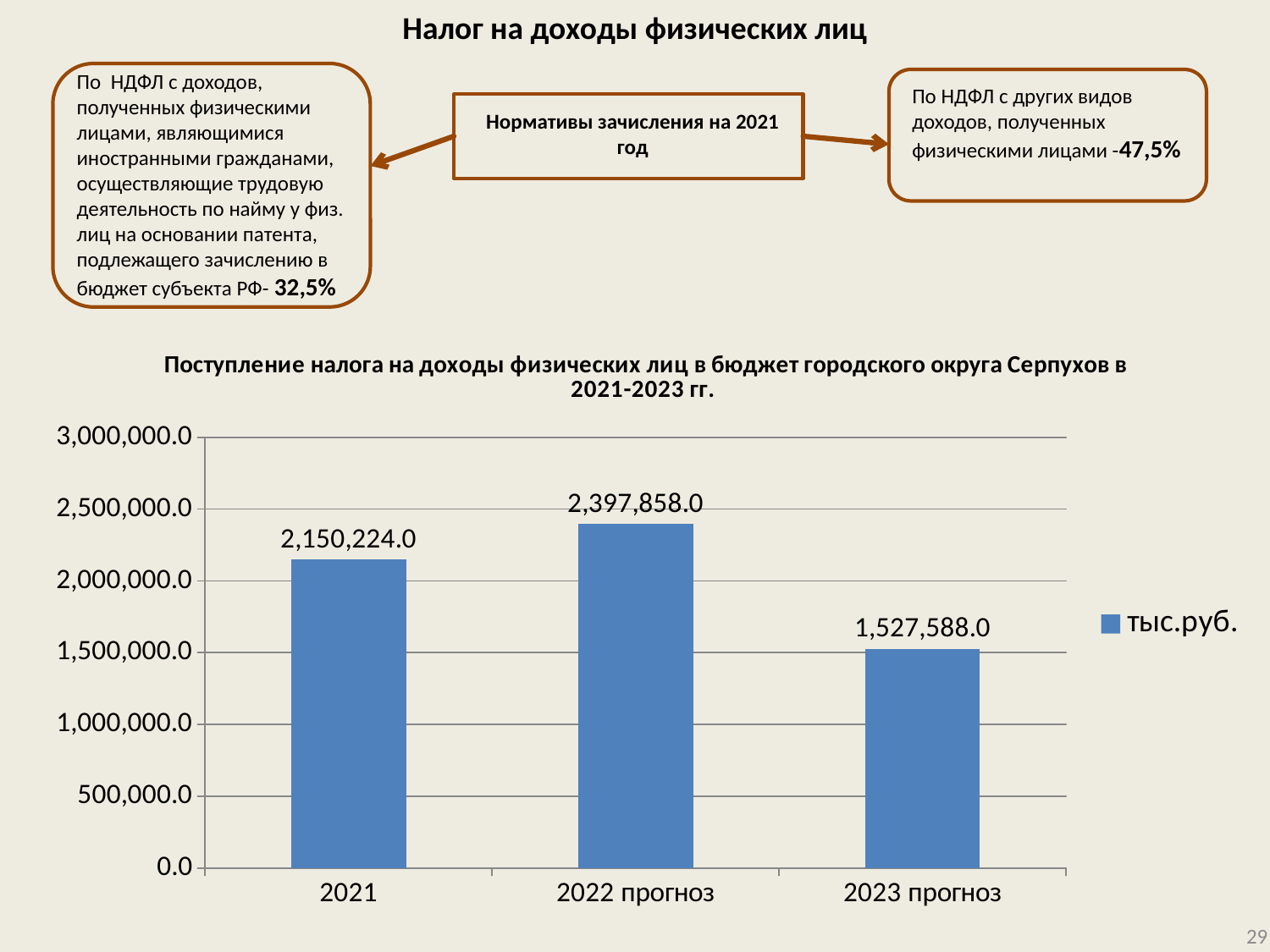
What is the value for 2023 прогноз in the chart? 1,527,588.0 What is the value for 2021 in the chart? 2,150,224.0 What series name does the chart legend show? тыс.руб. What kind of chart is shown on the slide? bar chart What is the difference between the values for 2022 прогноз and 2021? 247,634.0 Is the value for 2023 прогноз greater or less than 2,000,000.0? less What is the difference between the values for 2021 and 2023 прогноз? 622,636.0 Which category has the highest value in the chart? 2022 прогноз Which category has the lowest value in the chart? 2023 прогноз How many categories are shown on the x axis of the chart? 3 Which is larger, the value for 2021 or the value for 2023 прогноз? 2021 What is the value for 2022 прогноз in the chart? 2,397,858.0